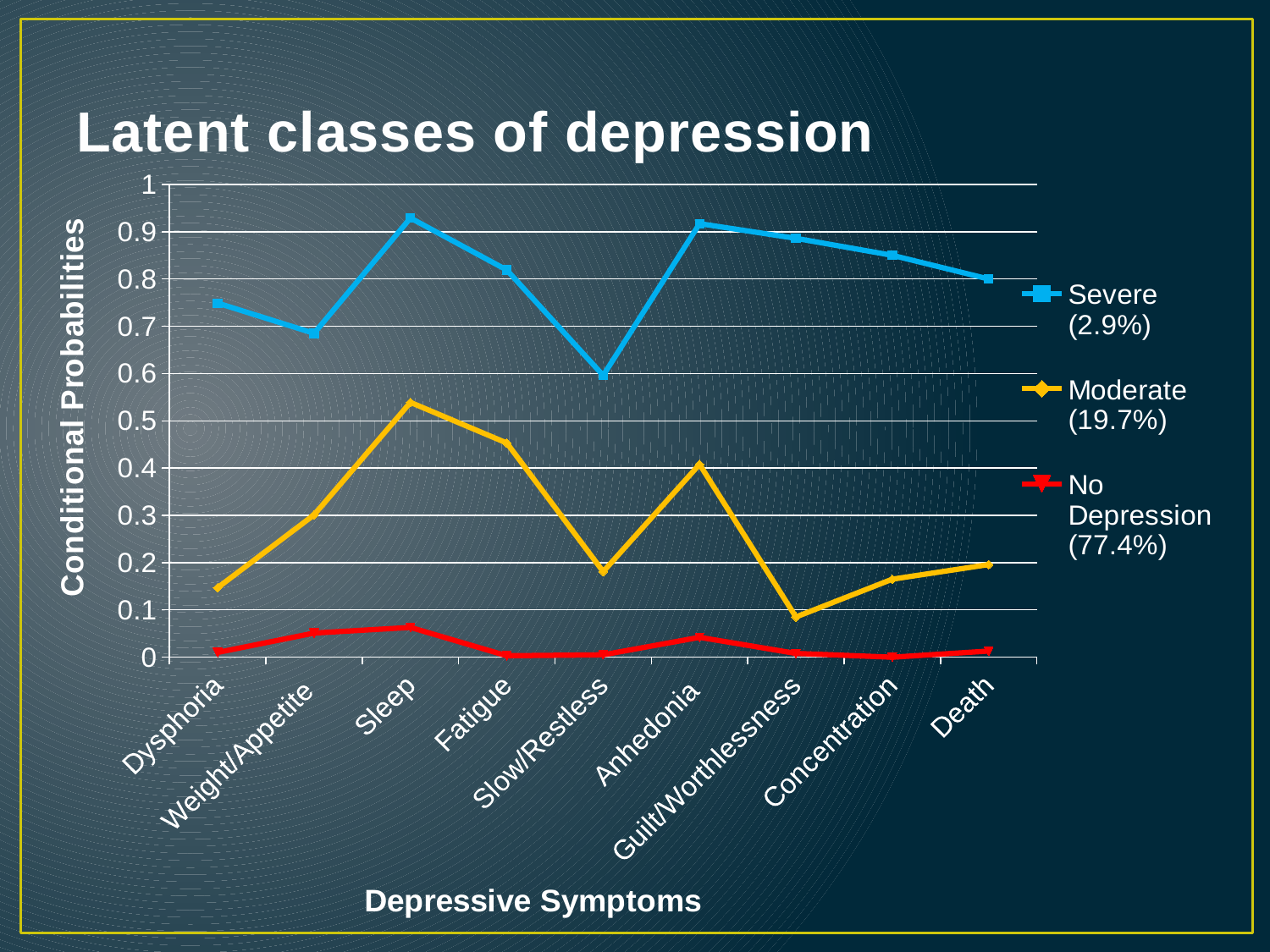
Does the Severe (2.9%) series rise or fall from Anhedonia to Death? Fall How many depressive symptoms are shown along the x axis? 9 What kind of chart is shown on the slide? Line chart What is the label of the y axis? Conditional Probabilities Is the No Depression (77.4%) value for Sleep greater or less than 0.1? less Is the Severe (2.9%) value for Sleep greater or less than 0.9? greater For which symptom is the Moderate (19.7%) series lowest? Guilt/Worthlessness Is the Moderate (19.7%) value for Dysphoria greater or less than 0.2? less Which is larger for the Moderate (19.7%) series: Sleep or Fatigue? Sleep For which symptom is the Severe (2.9%) series lowest? Slow/Restless For which symptom is the Moderate (19.7%) series highest? Sleep How many series does the legend list? 3